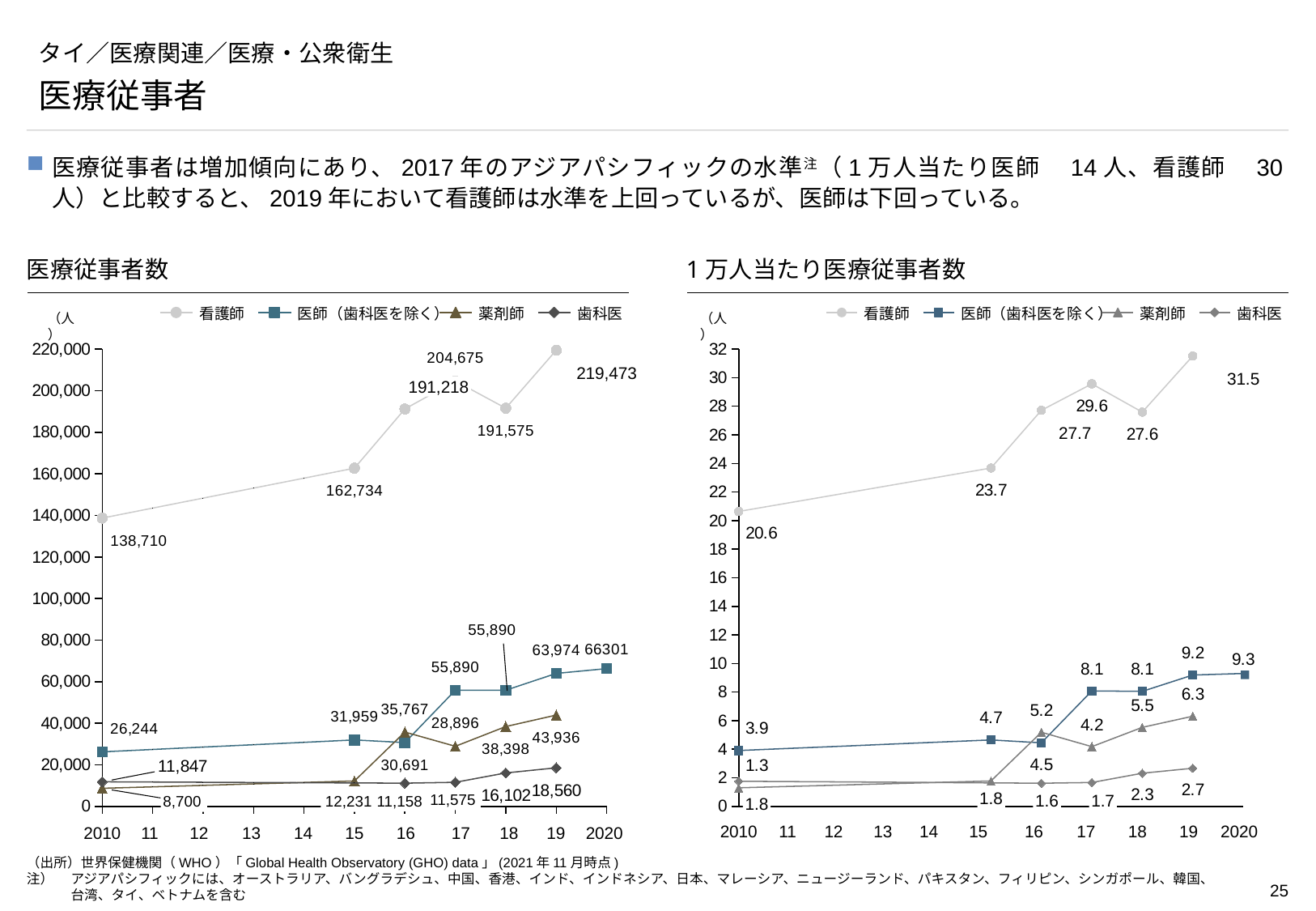
In the right chart (1万人当たり医療従事者数), what is the value for 看護師 in 2019? 31.5 How many series does the legend of the left chart (医療従事者数) list? 4 In the left chart (医療従事者数), what is the value for 看護師 in 2019? 219,473 In the right chart (1万人当たり医療従事者数), what is the value for 医師（歯科医を除く） in 2020? 9.3 In the left chart (医療従事者数), what is the value for 歯科医 in 2019? 18,560 In the right chart (1万人当たり医療従事者数), which is larger in 2017: 薬剤師 or 歯科医? 薬剤師 In the right chart (1万人当たり医療従事者数), is the 看護師 value in 2019 greater or less than 30? greater In the left chart (医療従事者数), what is the difference between the 看護師 values for 2019 and 2018? 27,898 In the left chart (医療従事者数), which series has the highest values throughout the period? 看護師 In the left chart (医療従事者数), what is the value for 医師（歯科医を除く） in 2010? 26,244 In the right chart (1万人当たり医療従事者数), what is the value for 薬剤師 in 2019? 6.3 What type of chart is the right chart (1万人当たり医療従事者数)? Line chart